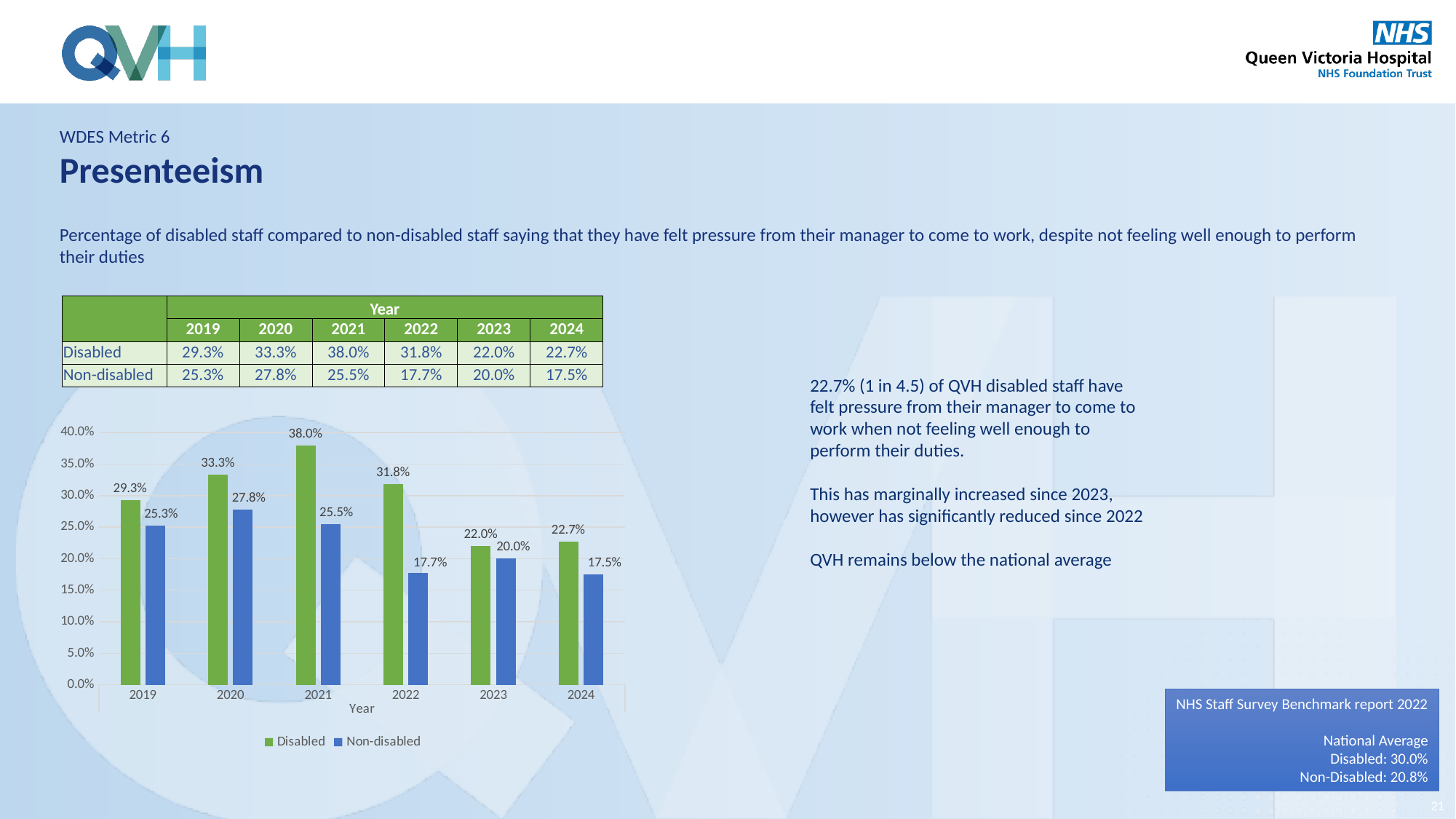
Does the Disabled series rise or fall from 2021 to 2023? Fall Which is larger in 2023, the Disabled value or the Non-disabled value? Disabled How many series does the chart legend list? 2 In which year is the Disabled series highest? 2021 What is the value for Disabled staff in 2024? 22.7% In which year is the Non-disabled series lowest? 2024 What is the value for Non-disabled staff in 2022? 17.7% What kind of chart is shown on the slide? Bar chart How many years are shown on the x axis of the chart? 6 What colour are the bars for the Non-disabled series? Blue What is the value for Disabled staff in 2021? 38.0% What is the difference between the Disabled and Non-disabled values in 2021? 12.5%